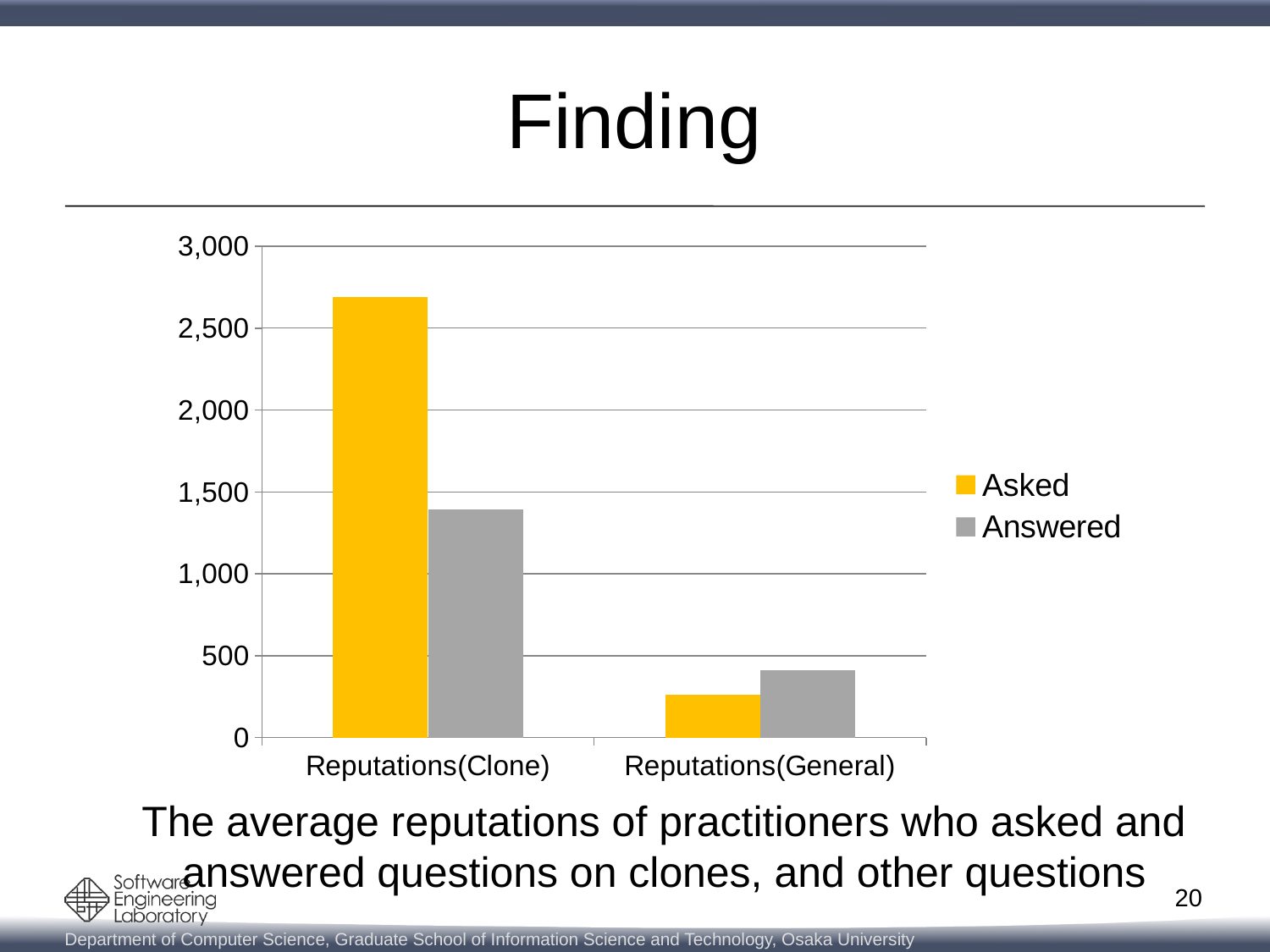
Is the Answered value for Reputations(General) greater or less than 500? less For Reputations(Clone), which is larger: Asked or Answered? Asked For Reputations(General), which is larger: Asked or Answered? Answered Is the Answered value for Reputations(Clone) greater or less than 1,500? less What colour are the Asked bars? yellow What are the two entries in the chart legend? Asked and Answered How many series does the legend list? 2 What kind of chart is shown on the slide? bar chart How many categories are shown on the x axis? 2 Which series and category has the lowest bar? Asked, Reputations(General) Which series and category has the highest bar? Asked, Reputations(Clone) Is the Asked value for Reputations(Clone) greater or less than 2,500? greater